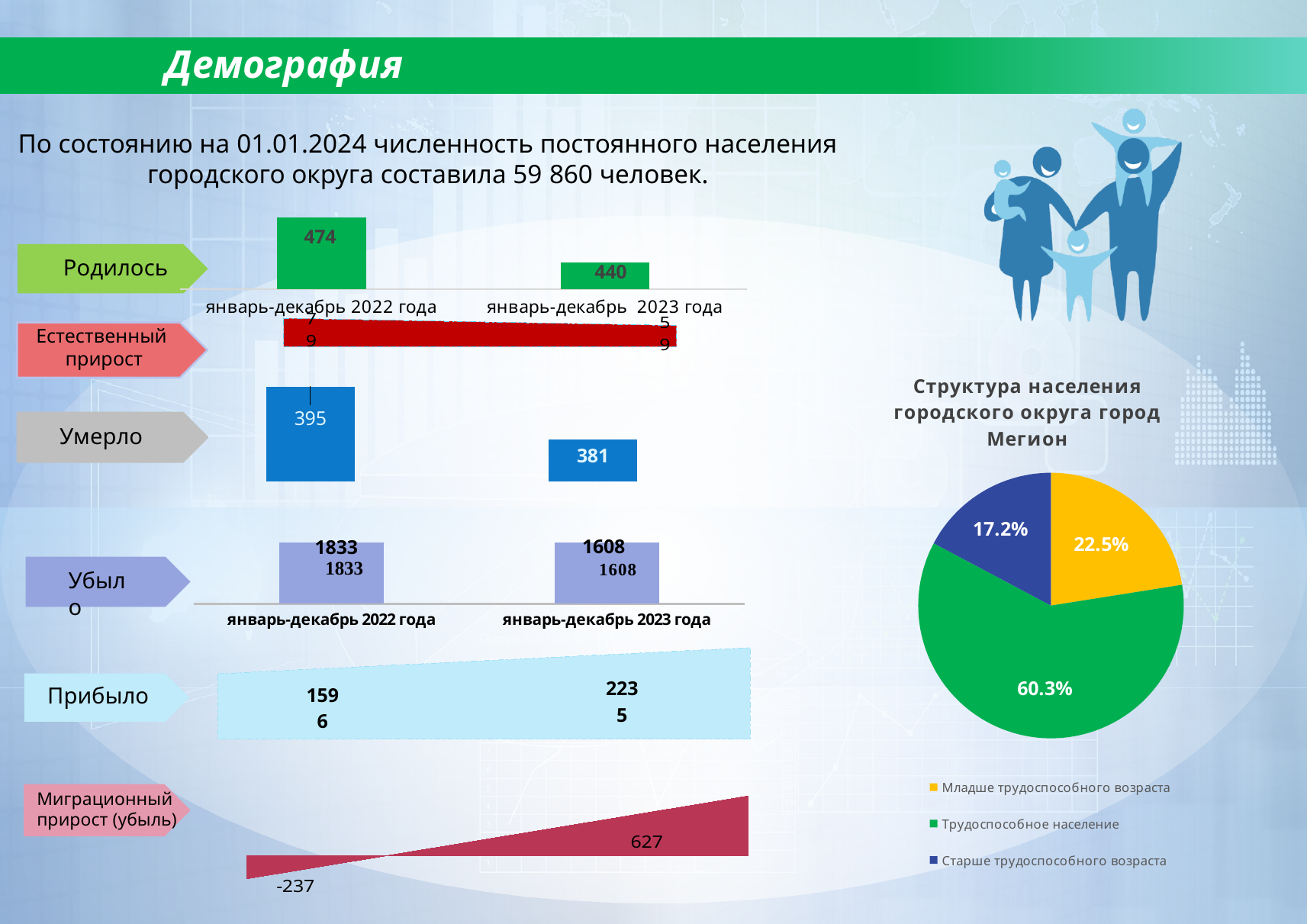
In the 'Миграционный прирост (убыль)' chart, what is the value for 2023? 627 In the pie chart 'Структура населения городского округа город Мегион', what share is 'Трудоспособное население'? 60.3% In the 'Умерло' bar chart, what is the value for январь-декабрь 2022 года? 395 In the 'Убыло' bar chart, what is the value for январь-декабрь 2023 года? 1608 In the 'Умерло' bar chart, which period has the lower value? январь-декабрь 2023 года In the 'Миграционный прирост (убыль)' chart, do the values rise or fall from 2022 to 2023? rise In the pie chart 'Структура населения городского округа город Мегион', which category has the smallest share? Старше трудоспособного возраста How many categories does the legend of the pie chart 'Структура населения городского округа город Мегион' list? 3 In the 'Родилось' bar chart, what is the difference between the 2022 and 2023 values? 34 In the 'Родилось' bar chart, what is the value for январь-декабрь 2022 года? 474 In the 'Родилось' bar chart, what is the value for январь-декабрь 2023 года? 440 In the 'Убыло' bar chart, what is the difference between the 2022 and 2023 values? 225